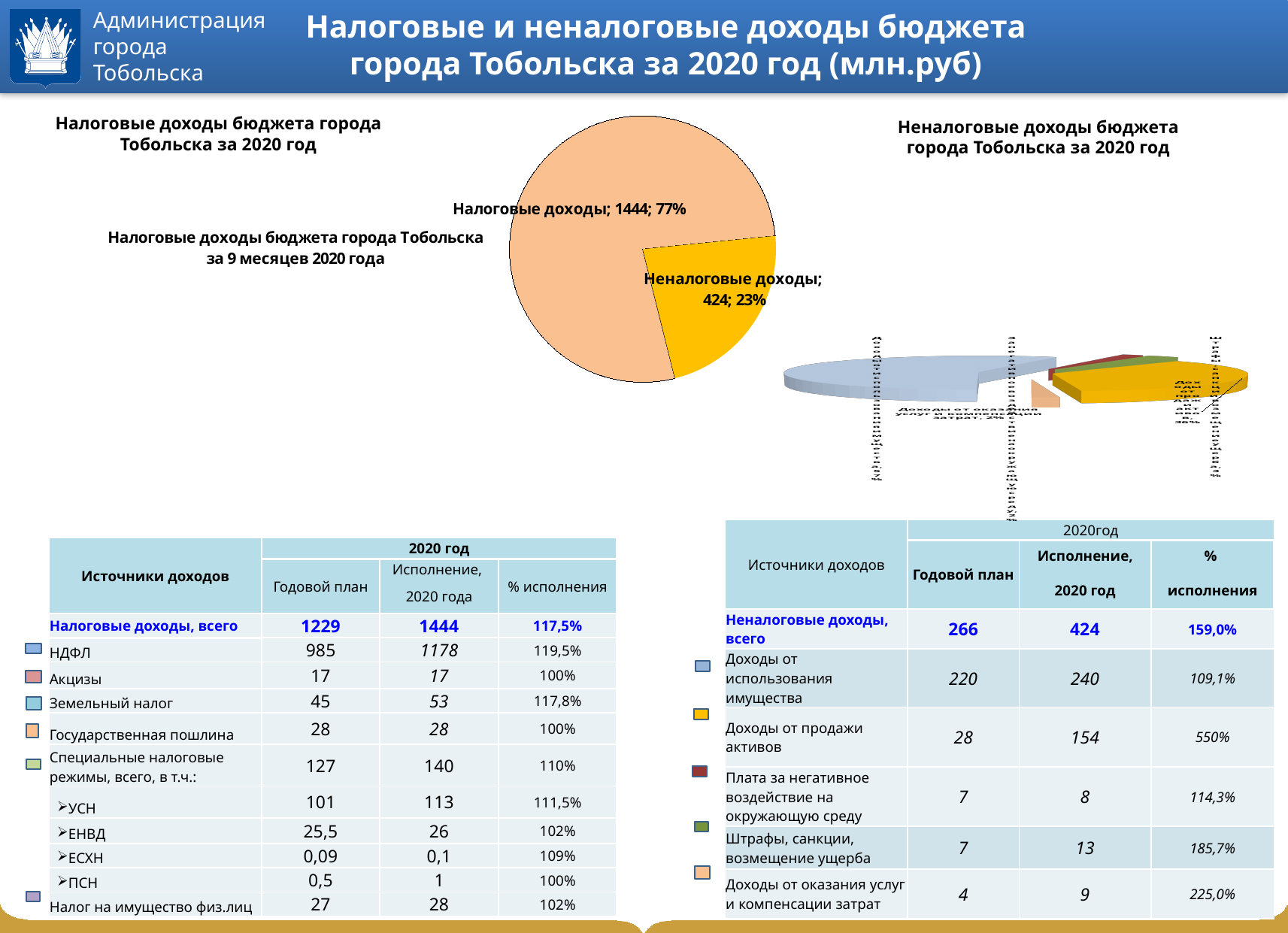
In the central pie chart, what is the difference between the values for Налоговые доходы and Неналоговые доходы? 1020 In the central pie chart, which is larger: Налоговые доходы or Неналоговые доходы? Налоговые доходы In the central pie chart, what colour is the Неналоговые доходы slice? yellow In the central pie chart, which slice is the smallest? Неналоговые доходы In the central pie chart, what is the total of the two slice values? 1868 What kind of chart is shown in the centre of the slide? pie chart In the central pie chart, what share of the pie does Налоговые доходы take? 77% How many slices does the central pie chart have? 2 In the central pie chart, what value is shown for Неналоговые доходы? 424 In the central pie chart, what share of the pie does Неналоговые доходы take? 23% In the central pie chart, what value is shown for Налоговые доходы? 1444 In the central pie chart, which slice is the largest? Налоговые доходы